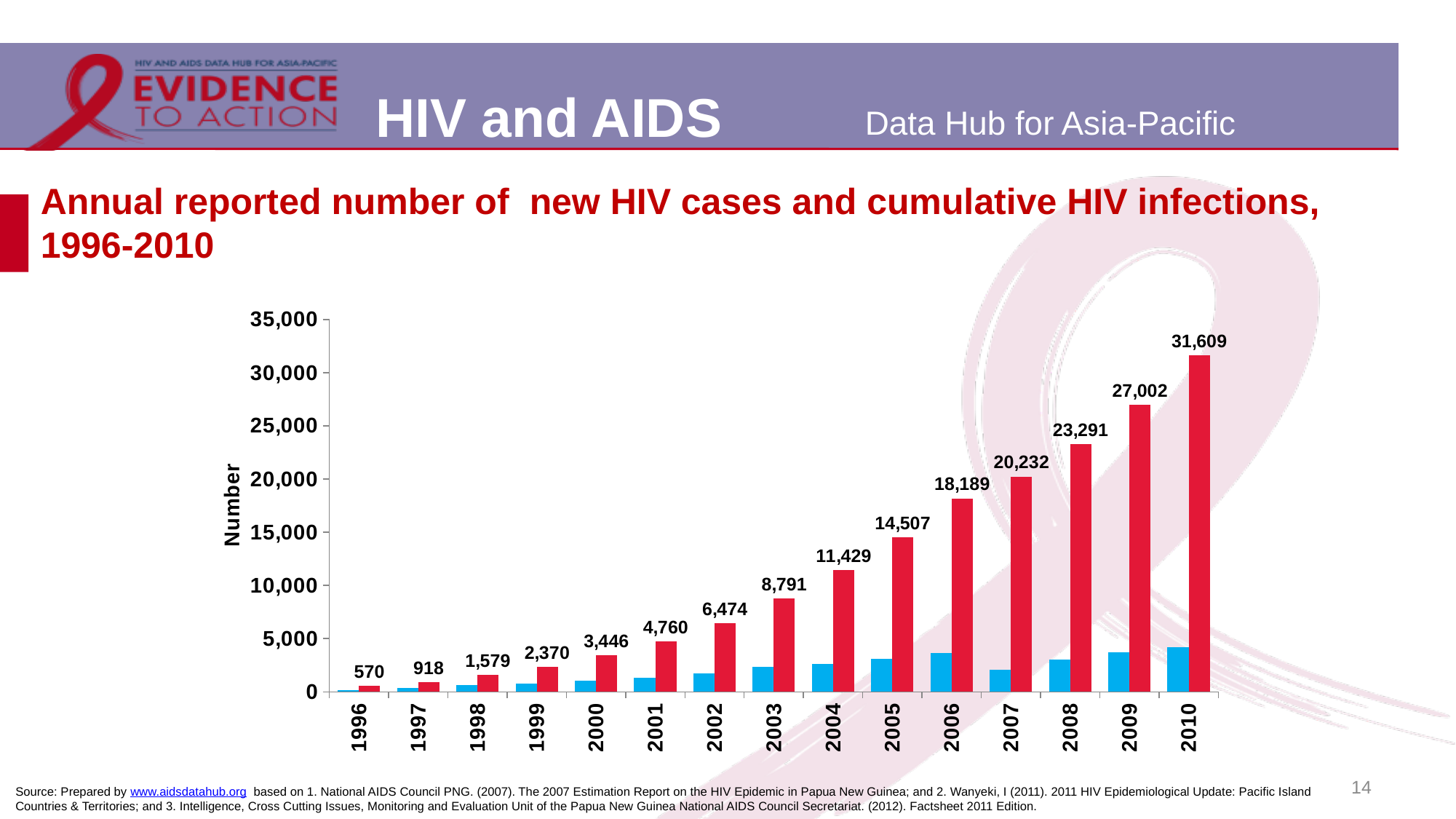
Which is larger, the red bar value for 2005 or for 2004? 2005 What is the labelled value of the red bar for 2010? 31,609 What is the labelled value of the red bar for 1996? 570 What is the labelled value of the red bar for 2007? 20,232 What kind of chart is shown on the slide? bar chart What is the difference between the red bar values for 2010 and 2009? 4,607 How many years are shown on the x axis? 15 Do the red bar values rise or fall from 1996 to 2010? rise Which year has the highest red bar value? 2010 What is the labelled value of the red bar for 2003? 8,791 Is the value of the blue bar for 2010 greater or less than 5,000? less Which year has the lowest red bar value? 1996